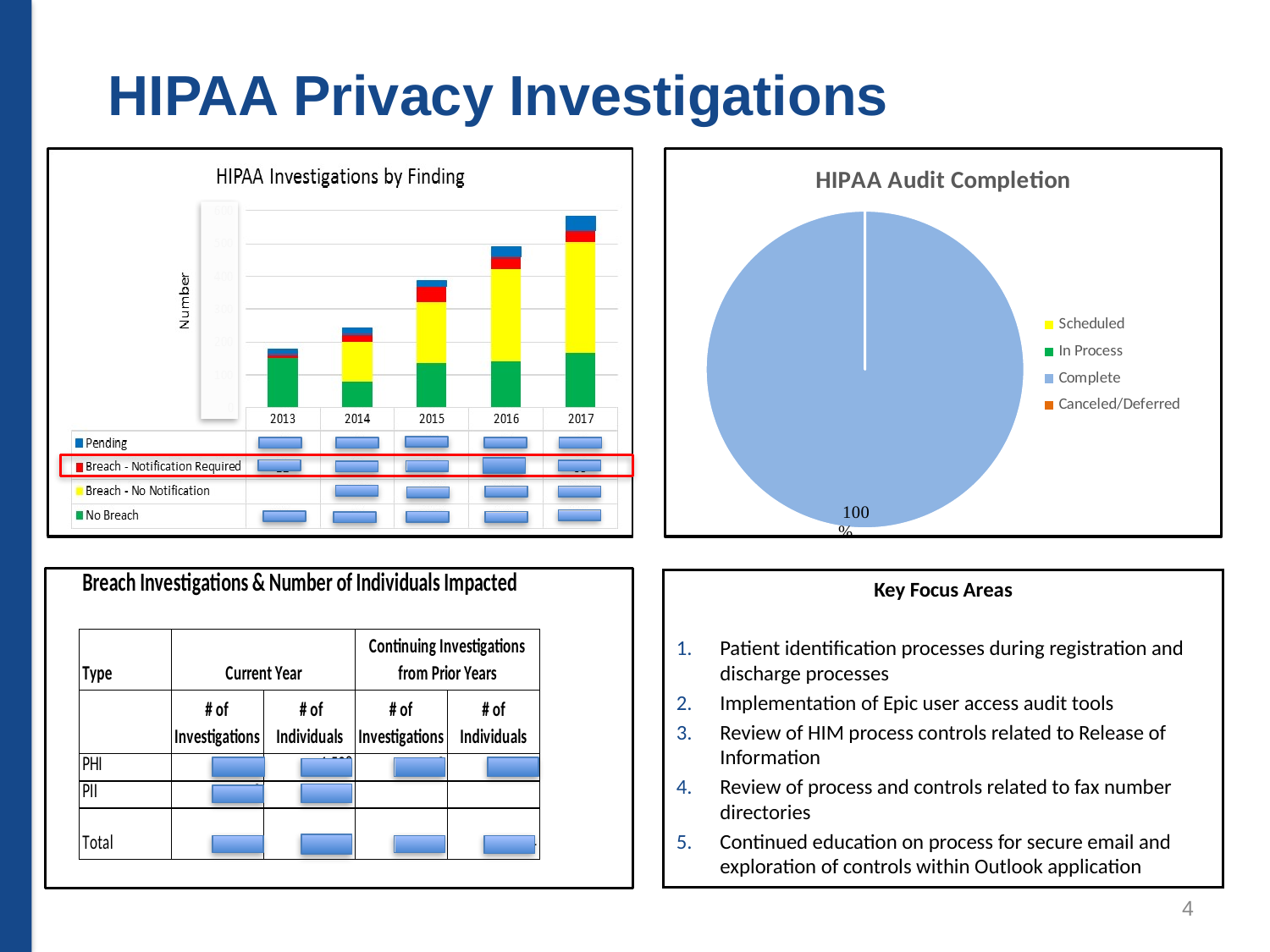
In the "HIPAA Audit Completion" chart, what share of the pie is Complete? 100% In the "HIPAA Investigations by Finding" chart, is the total stacked bar for 2016 larger or smaller than the one for 2014? Larger What kind of chart is the "HIPAA Audit Completion" chart? Pie chart In the "HIPAA Investigations by Finding" chart, which series is shown in yellow? Breach - No Notification In the "HIPAA Investigations by Finding" chart, do the total investigations rise or fall from 2013 to 2017? Rise In the "HIPAA Investigations by Finding" chart, how many years are shown on the x axis? 5 In the "HIPAA Investigations by Finding" chart, how many series does the legend list? 4 In the "HIPAA Audit Completion" chart, which legend category makes up the entire pie? Complete In the "HIPAA Investigations by Finding" chart, which year has the shortest stacked bar? 2013 What kind of chart is the "HIPAA Investigations by Finding" chart? Stacked bar chart In the "HIPAA Audit Completion" chart, how many entries does the legend list? 4 In the "HIPAA Investigations by Finding" chart, which year has the tallest stacked bar? 2017